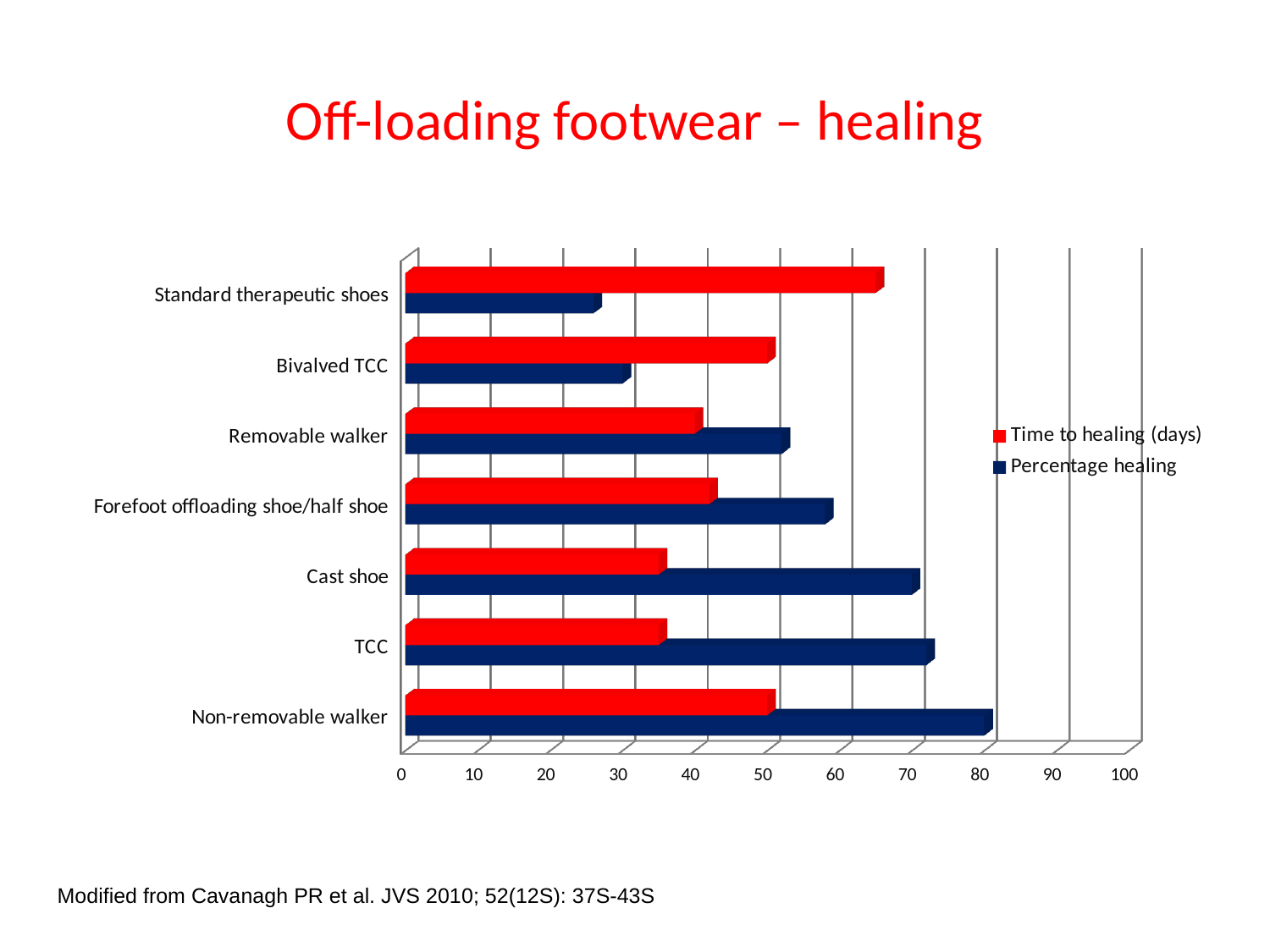
Which footwear category has the lowest percentage healing? Standard therapeutic shoes Which footwear category has the highest percentage healing? Non-removable walker Is the time to healing (days) for Cast shoe greater or less than 40? less Which colour represents the Percentage healing series in the legend? Dark blue Which has the larger percentage healing, Cast shoe or Bivalved TCC? Cast shoe How many series does the legend list? 2 Which footwear category has the longest time to healing (days)? Standard therapeutic shoes Is the time to healing (days) for Standard therapeutic shoes greater or less than 60? greater Is the percentage healing for Non-removable walker greater or less than 70? greater What kind of chart is shown on the slide? Bar chart How many footwear categories are plotted on the chart? 7